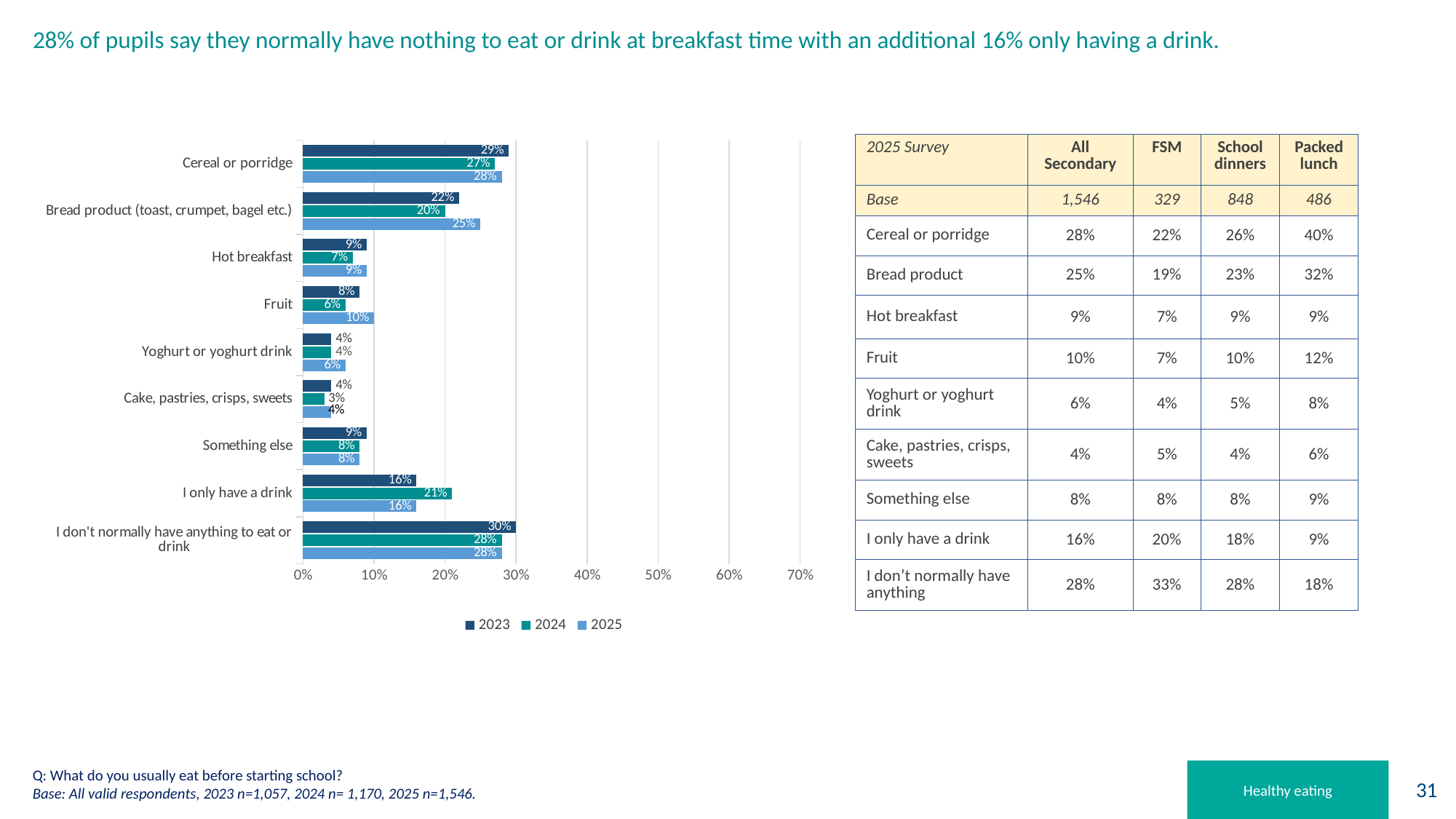
Which category has the highest 2023 value in the bar chart? I don't normally have anything to eat or drink What is the 2023 value for 'I don't normally have anything to eat or drink' in the bar chart? 30% What is the 2025 value for 'Bread product (toast, crumpet, bagel etc.)' in the bar chart? 25% How many categories are shown in the bar chart? 9 How many series does the legend of the bar chart list? 3 In the bar chart, is the 2025 value for 'Fruit' larger than the 2024 value for 'Fruit'? Yes, 2025 (10%) is larger than 2024 (6%) What is the difference between the 2025 and 2024 values for 'Bread product (toast, crumpet, bagel etc.)' in the bar chart? 5% Which category has the lowest 2024 value in the bar chart? Cake, pastries, crisps, sweets Which years are listed in the legend of the bar chart? 2023, 2024, 2025 Is the 2023 value for 'Cereal or porridge' in the bar chart greater or less than 20%? greater What is the 2024 value for 'I only have a drink' in the bar chart? 21% What kind of chart is shown on the slide? Bar chart